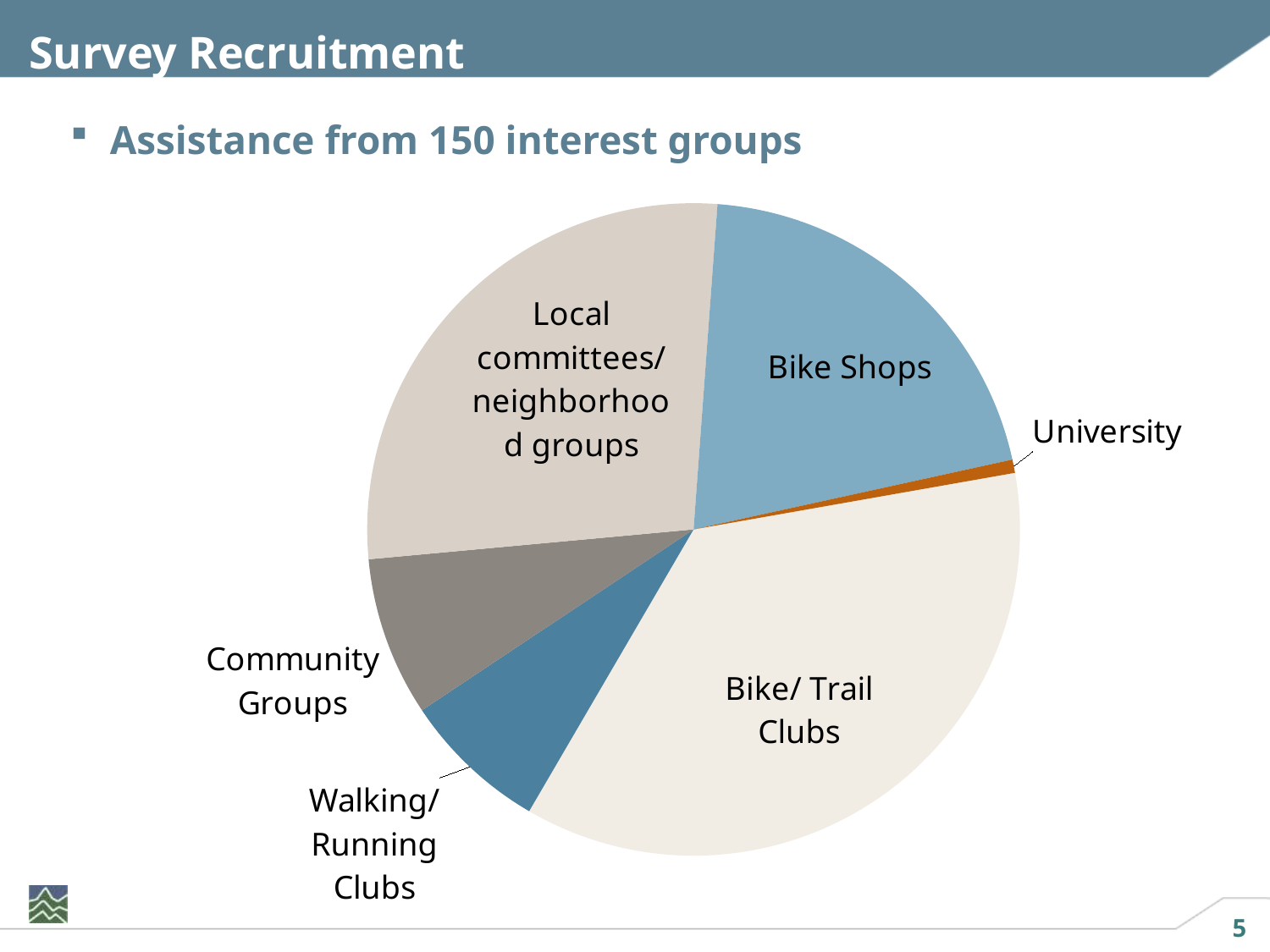
Which slice is larger: Local committees/neighborhood groups or Walking/ Running Clubs? Local committees/neighborhood groups Which slice is larger: Bike/ Trail Clubs or Local committees/neighborhood groups? Bike/ Trail Clubs What colour is the University slice of the pie chart? Orange Which category has the largest slice of the pie chart? Bike/ Trail Clubs Which slice is larger: Bike Shops or Community Groups? Bike Shops Which category has the smallest slice of the pie chart? University What kind of chart is shown on the slide? Pie chart According to the bullet text above the chart, how many interest groups provided assistance? 150 How many slices does the pie chart have? 6